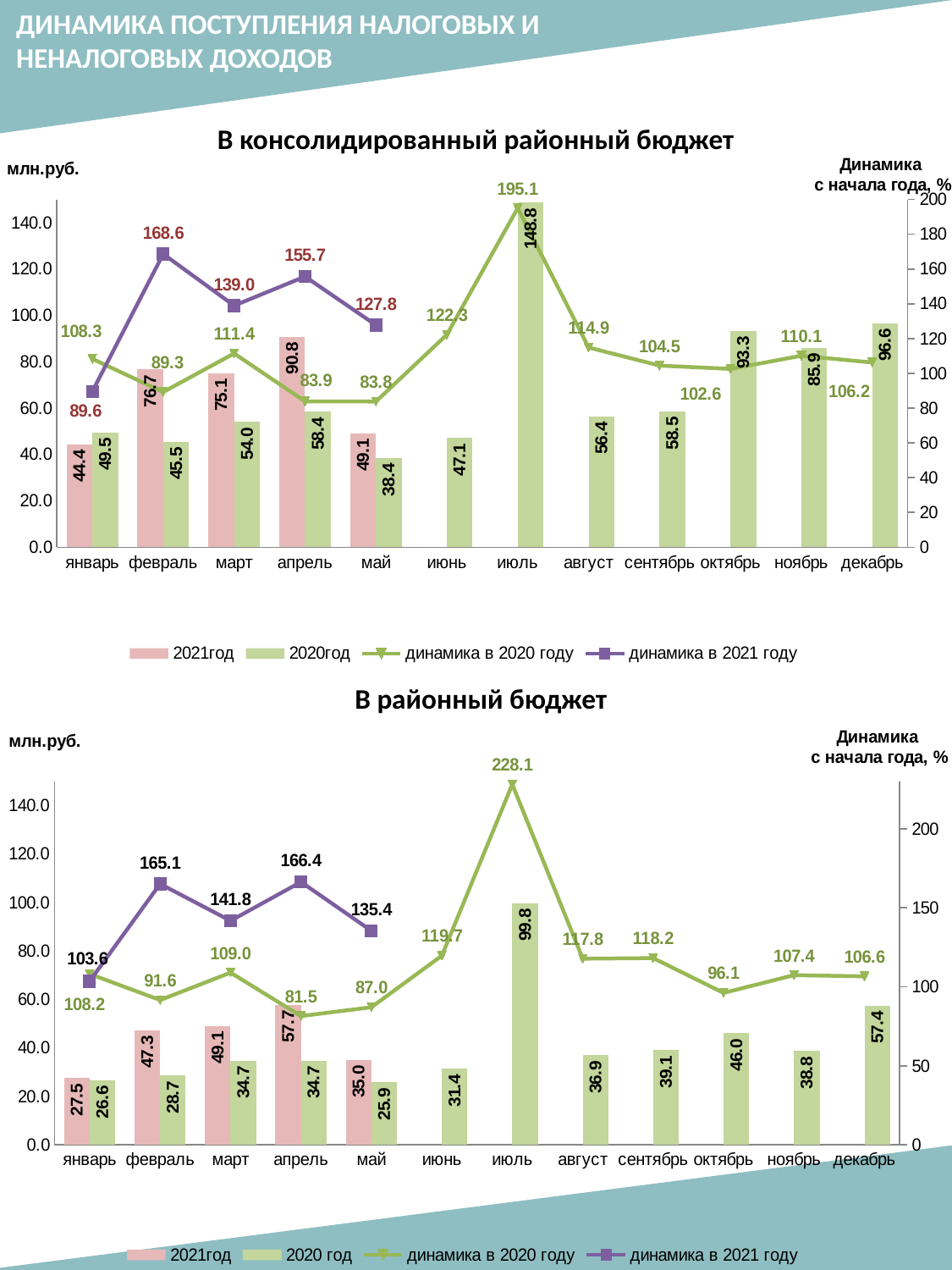
On the chart 'В консолидированный районный бюджет', which month has the highest 2020год bar? июль On the chart 'В консолидированный районный бюджет', what is the difference between the 2021год and 2020год bars for февраль? 31.2 On the chart 'В районный бюджет', what is the value of 'динамика в 2021 году' for апрель? 166.4 On the chart 'В районный бюджет', which is larger for март: the 2021год bar or the 2020 год bar? 2021год On the chart 'В консолидированный районный бюджет', what is the value of the 2021год bar for апрель? 90.8 What kind of chart is 'В районный бюджет'? Combined bar and line chart On the chart 'В консолидированный районный бюджет', which month has the lowest 2020год bar? май On the chart 'В консолидированный районный бюджет', what is the value of 'динамика в 2021 году' for февраль? 168.6 On the chart 'В районный бюджет', what is the value of 'динамика в 2020 году' for июль? 228.1 On the chart 'В районный бюджет', what is the value of the 2020 год bar for июль? 99.8 On the chart 'В районный бюджет', how many months have a 2021год bar? 5 How many series does the legend of the chart 'В консолидированный районный бюджет' list? 4